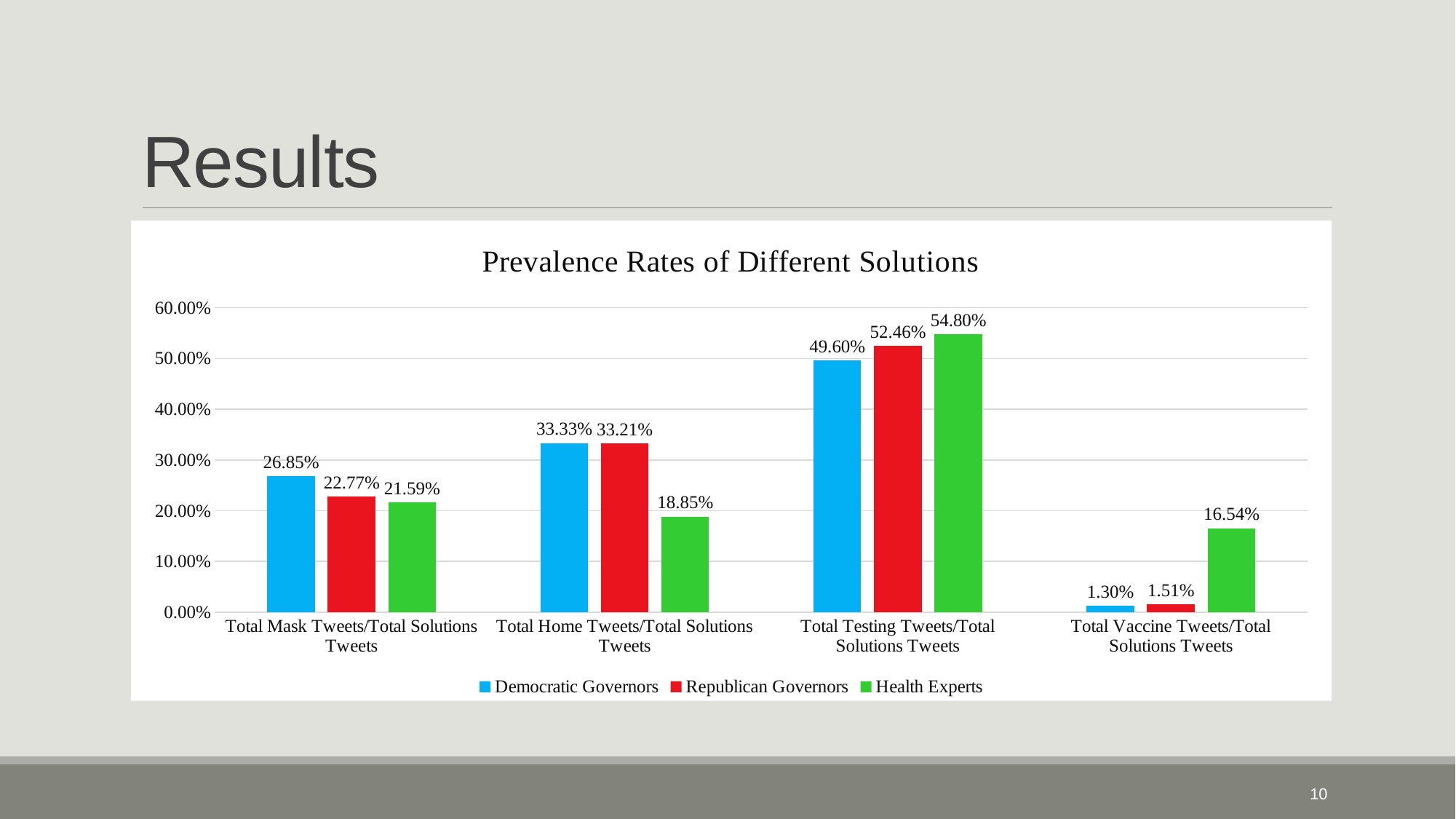
What is the difference between the Health Experts and Democratic Governors values in the Total Testing Tweets/Total Solutions Tweets category? 5.20% What is the value for Republican Governors in the Total Testing Tweets/Total Solutions Tweets category? 52.46% Which category has the lowest value for Democratic Governors? Total Vaccine Tweets/Total Solutions Tweets How many series does the legend list? 3 What is the title of the chart? Prevalence Rates of Different Solutions How many categories are shown on the x axis? 4 Is the value for Republican Governors in the Total Mask Tweets/Total Solutions Tweets category greater or less than 30.00%? less Which category has the highest value for Health Experts? Total Testing Tweets/Total Solutions Tweets What kind of chart is shown on the slide? bar chart What is the value for Democratic Governors in the Total Mask Tweets/Total Solutions Tweets category? 26.85% In the Total Home Tweets/Total Solutions Tweets category, which is larger: Democratic Governors or Health Experts? Democratic Governors What is the value for Health Experts in the Total Vaccine Tweets/Total Solutions Tweets category? 16.54%